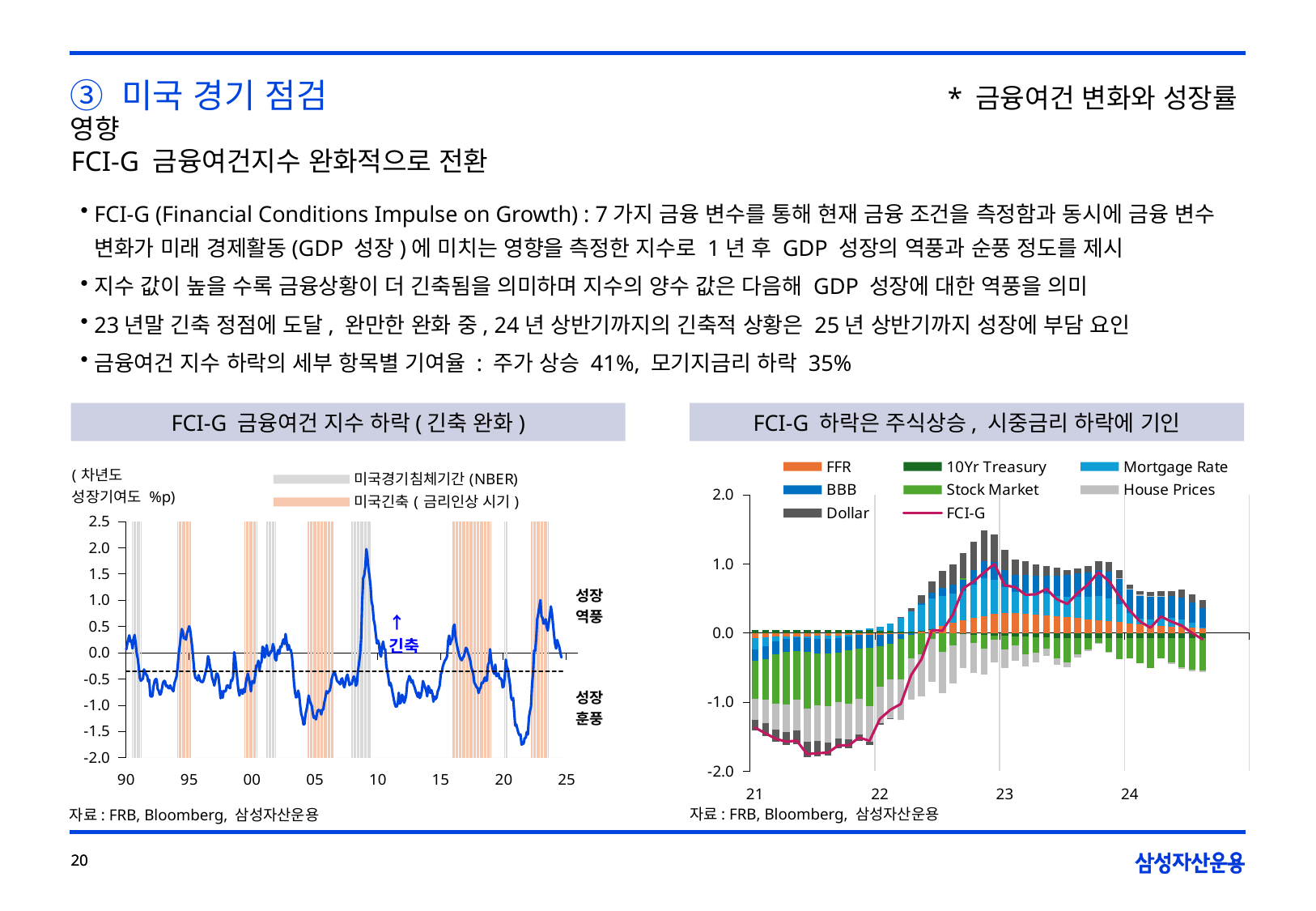
In the right chart, does the FCI-G line rise or fall from the start of 2022 to the start of 2023? rise In the left chart, is the FCI-G value at the 2023 peak greater or less than 0.5? greater In the right chart, is the FCI-G line at the start of 2021 greater or less than -1.0? less What kind of chart is the left chart titled 'FCI-G 금융여건 지수 하락 (긴축 완화)'? line chart In the left chart, what do the orange shaded bands represent according to the legend? 미국긴축 (금리인상 시기) What is the maximum value shown on the y-axis of the left chart? 2.5 In the right chart, which legend entry is drawn as a line rather than bars? FCI-G In the right chart, does the FCI-G line rise or fall from the start of 2023 to the end of 2024? fall In the left chart, is the peak value of the FCI-G line around 2009 greater or less than 1.5? greater How many series does the legend of the right chart list? 8 What kind of chart is the right chart titled 'FCI-G 하락은 주식상승, 시중금리 하락에 기인'? stacked bar chart with a line